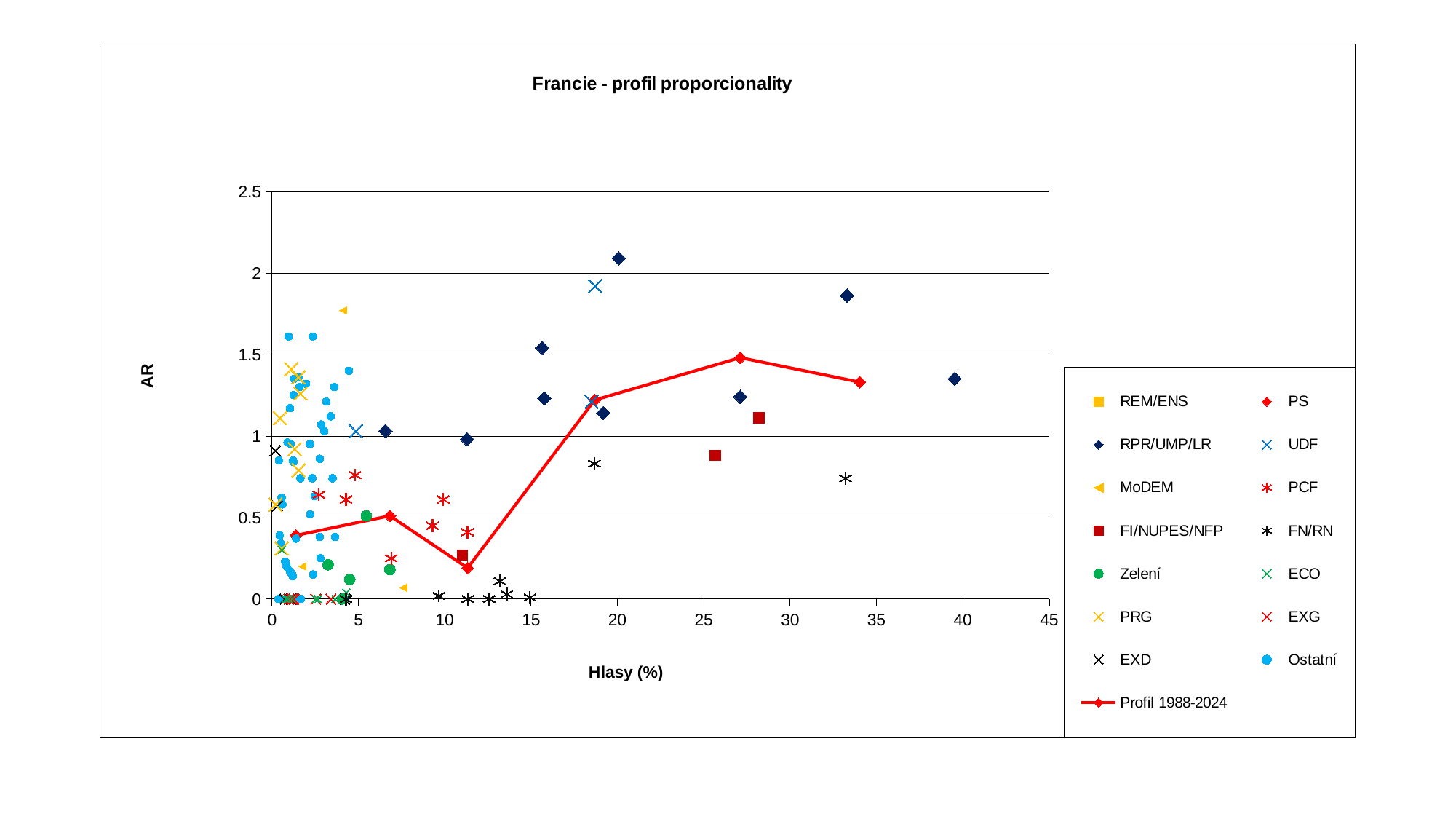
Is the lowest point of the Profil 1988-2024 line greater or less than 0.5 on the AR axis? less How many series does the legend list? 15 Is the FN/RN point near 33% of votes greater or less than 1 on the AR axis? less How many points does the Profil 1988-2024 line have? 6 What kind of chart is shown on the slide? scatter chart Is the highest RPR/UMP/LR point greater or less than 2 on the AR axis? greater What is the label of the x axis? Hlasy (%) Which series has the point with the highest AR value on the chart? RPR/UMP/LR What is the title of the chart? Francie - profil proporcionality Which series has the point furthest to the right on the Hlasy (%) axis? RPR/UMP/LR Does the Profil 1988-2024 line rise or fall between its point near 27% and its point near 34% of votes? fall